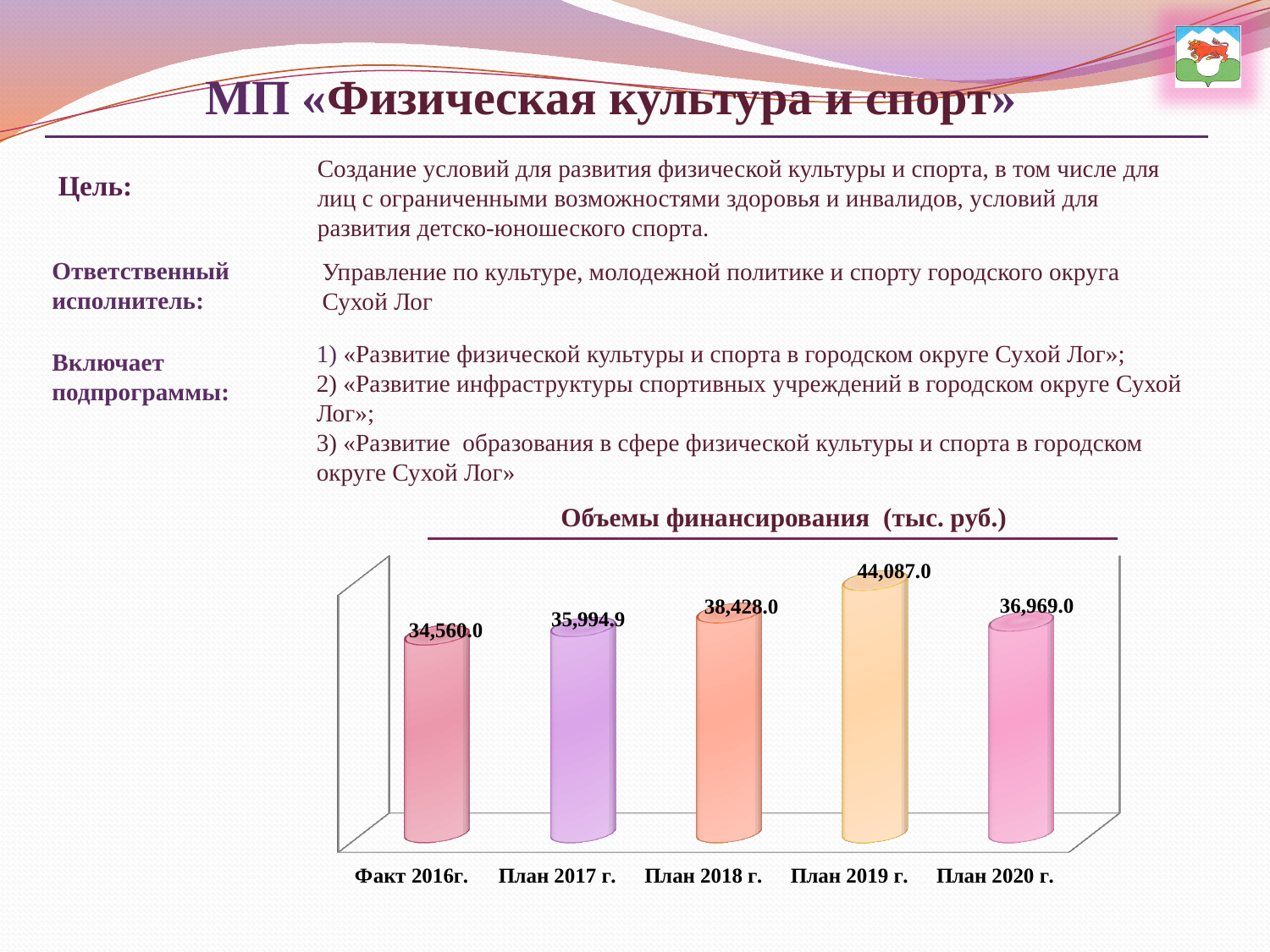
What is the difference between the values for План 2019 г. and Факт 2016г.? 9,527.0 What is the value for План 2017 г. in the chart? 35,994.9 What is the difference between the values for План 2018 г. and План 2017 г.? 2,433.1 Do the values rise or fall from Факт 2016г. to План 2019 г.? Rise How many categories are shown in the chart? 5 What is the value for Факт 2016г. in the chart «Объемы финансирования (тыс. руб.)»? 34,560.0 What is the value for План 2020 г. in the chart? 36,969.0 Which category has the lowest value in the chart? Факт 2016г. What kind of chart is shown on the slide? Bar chart Which category has the highest value in the chart? План 2019 г. What is the value for План 2018 г. in the chart? 38,428.0 Which is larger, the value for План 2018 г. or the value for План 2020 г.? План 2018 г.